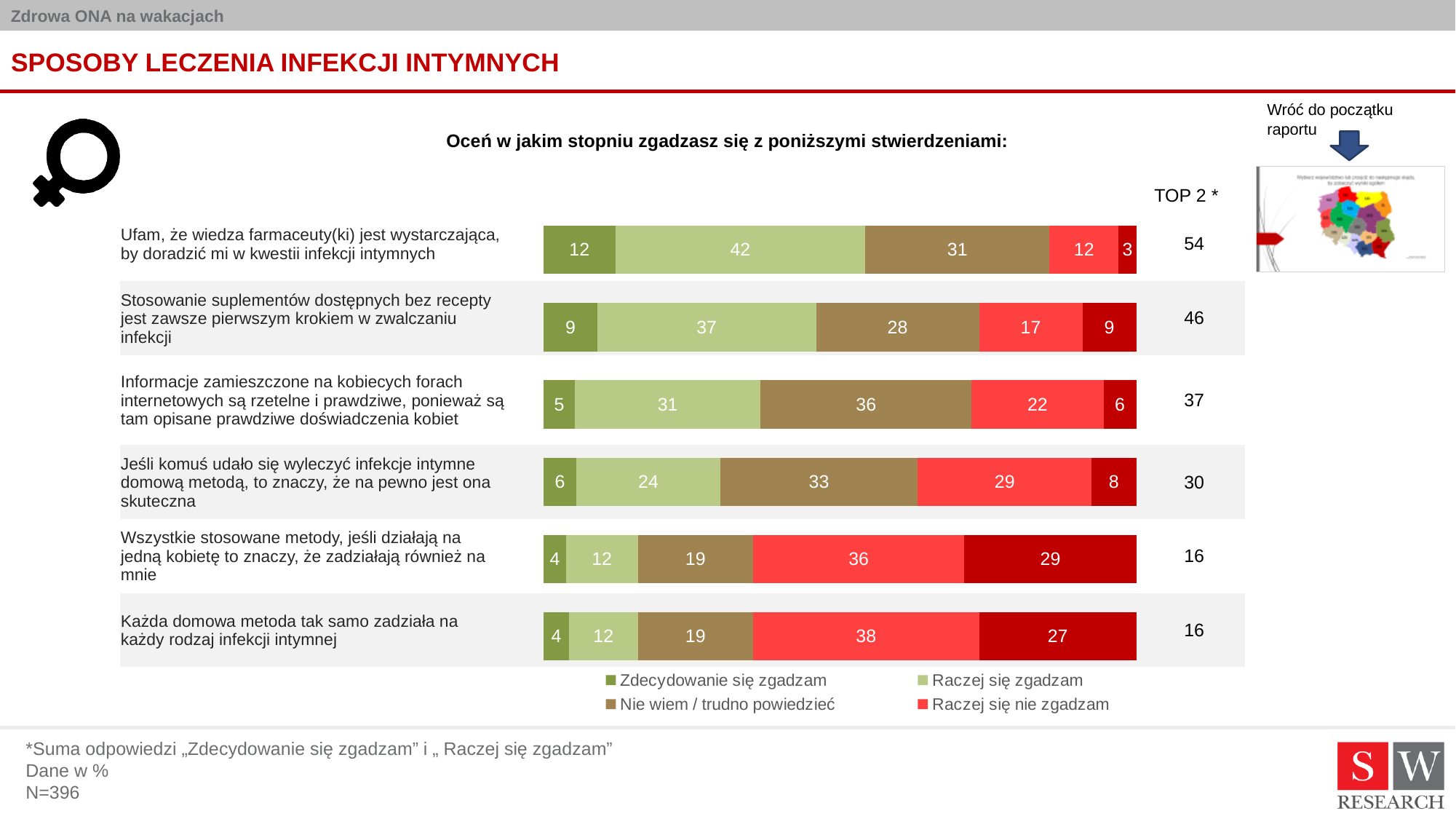
Which is larger: the 'Raczej się zgadzam' value for 'Stosowanie suplementów dostępnych bez recepty...' or for 'Jeśli komuś udało się wyleczyć infekcje intymne domową metodą...'? Stosowanie suplementów dostępnych bez recepty... What is the TOP 2 value for the statement 'Stosowanie suplementów dostępnych bez recepty jest zawsze pierwszym krokiem w zwalczaniu infekcji'? 46 What is the lowest TOP 2 value shown in the chart? 16 How many series does the chart's legend list? 4 What is the 'Raczej się zgadzam' value for the statement 'Ufam, że wiedza farmaceuty(ki) jest wystarczająca, by doradzić mi w kwestii infekcji intymnych'? 42 What is the sample size (N) stated on the slide? N=396 What is the difference between the 'Raczej się nie zgadzam' values for 'Każda domowa metoda tak samo zadziała na każdy rodzaj infekcji intymnej' and 'Wszystkie stosowane metody, jeśli działają na jedną kobietę...'? 2 Which statement has the highest TOP 2 value? Ufam, że wiedza farmaceuty(ki) jest wystarczająca, by doradzić mi w kwestii infekcji intymnych What is the total of the 'Zdecydowanie się zgadzam' and 'Raczej się zgadzam' segments for 'Jeśli komuś udało się wyleczyć infekcje intymne domową metodą, to znaczy, że na pewno jest ona skuteczna'? 30 What is the 'Nie wiem / trudno powiedzieć' value for the statement 'Informacje zamieszczone na kobiecych forach internetowych są rzetelne i prawdziwe...'? 36 What kind of chart is shown on the slide? stacked bar chart How many statements (categories) are plotted in the chart? 6